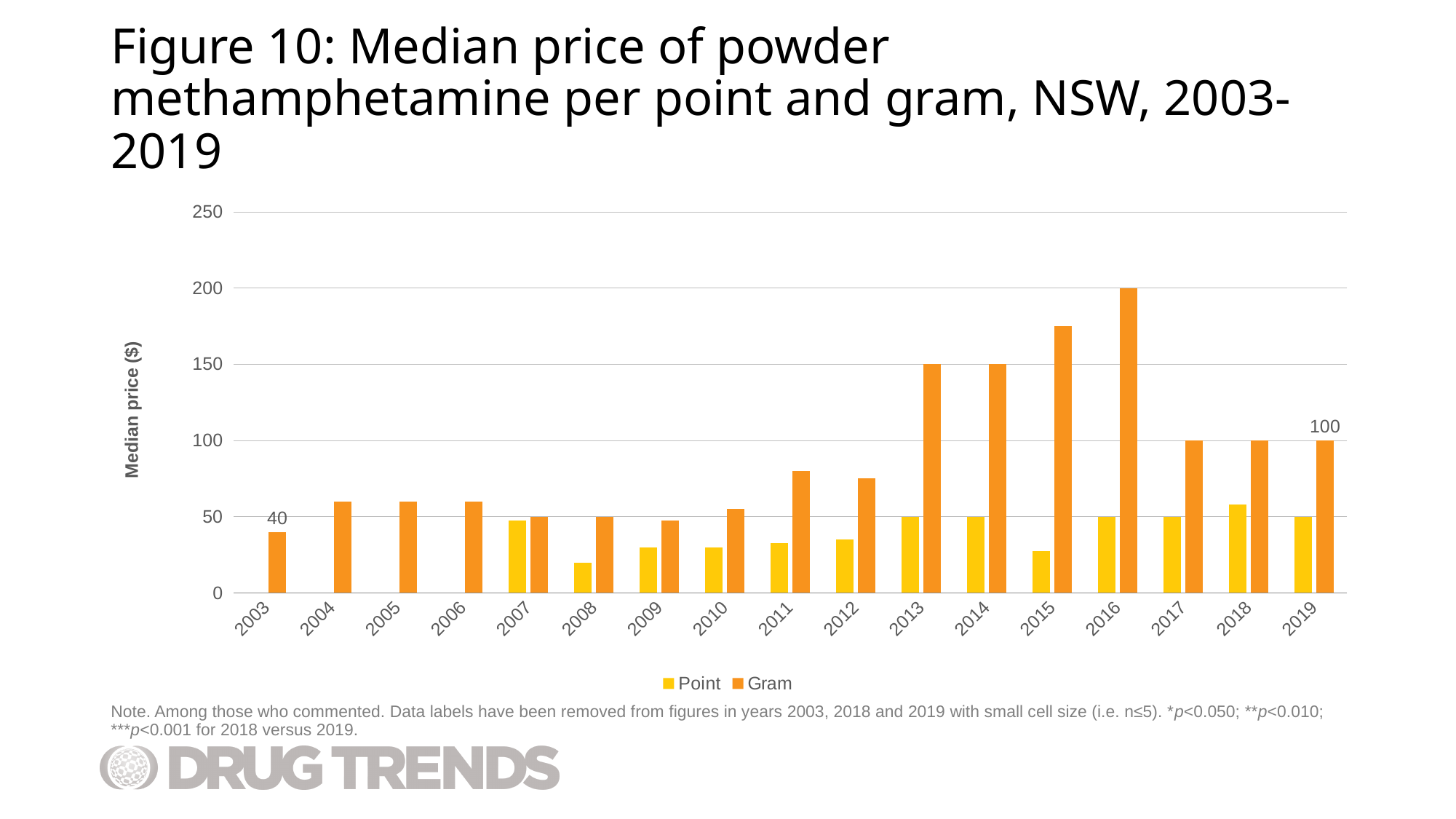
In which year is the median price per point lowest? 2008 Is the median price per gram in 2016 greater or less than 150? greater What is the median price per gram in 2003? 40 What is the median price per gram in 2019? 100 What is the difference between the median price per gram in 2019 and in 2003? 60 Which is larger in 2019, the price per point or the price per gram? Gram How many series does the legend list? 2 What kind of chart is shown on the slide? Bar chart How many years are shown on the x axis? 17 In which year is the median price per gram highest? 2016 What is the label on the y axis? Median price ($) Is the median price per point in 2008 greater or less than 50? less